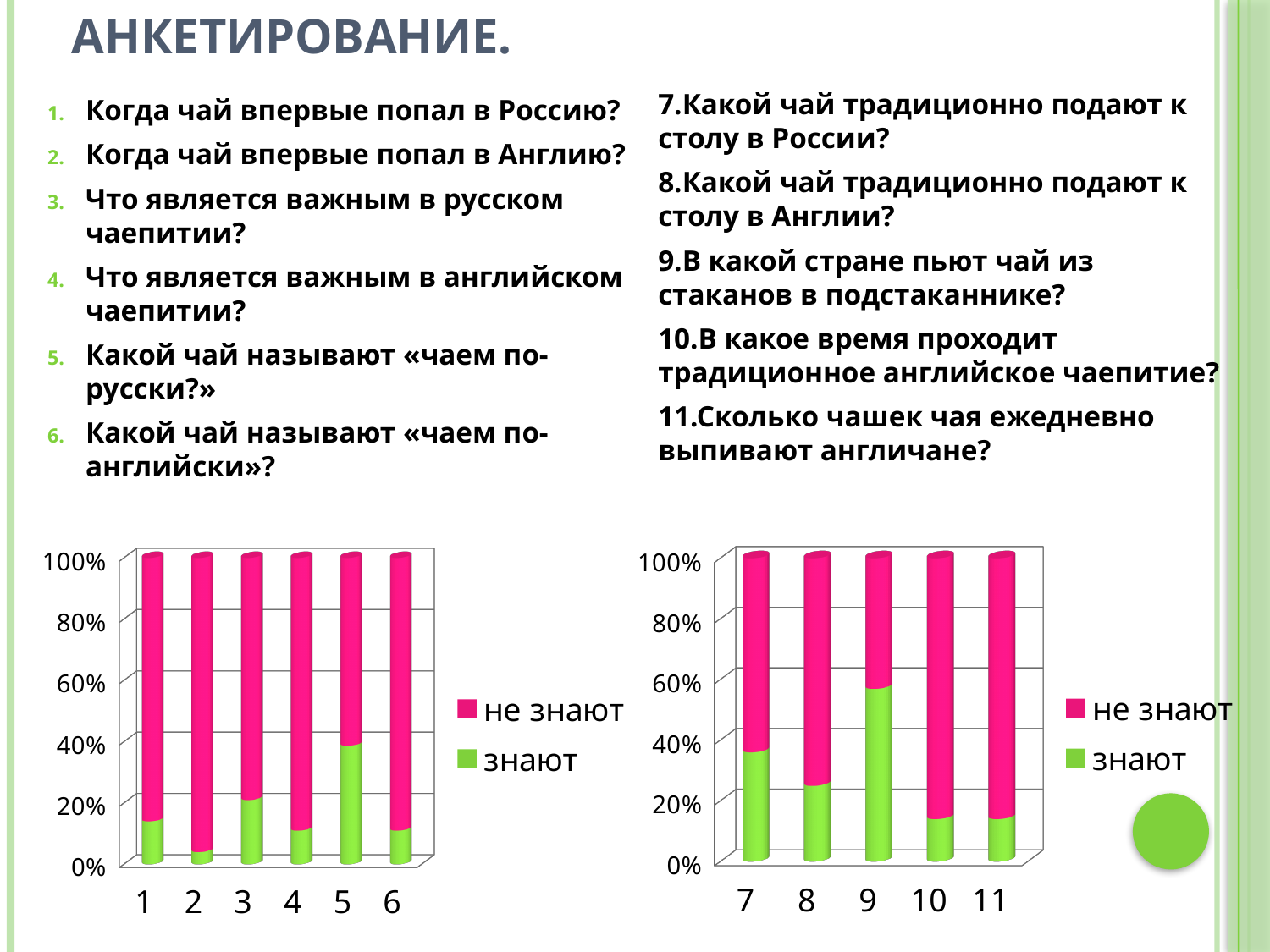
How many categories does the left chart (categories 1 to 6) show? 6 In the right chart (categories 7 to 11), is the "знают" share for category 9 greater or less than 40%? greater What kind of chart is the left chart (categories 1 to 6)? stacked bar chart In the left chart (categories 1 to 6), which category has the lowest share of "знают"? 2 How many categories does the right chart (categories 7 to 11) show? 5 In the right chart (categories 7 to 11), which has the larger "знают" share: category 7 or category 8? 7 What are the two legend entries of the left chart (categories 1 to 6)? не знают, знают In the left chart (categories 1 to 6), which category has the highest share of "знают"? 5 In the right chart (categories 7 to 11), which category has the highest share of "знают"? 9 In the left chart (categories 1 to 6), is the "знают" share for category 5 greater or less than 20%? greater How many series does the legend of the right chart (categories 7 to 11) list? 2 In the right chart (categories 7 to 11), is the "знают" share for category 10 greater or less than 20%? less